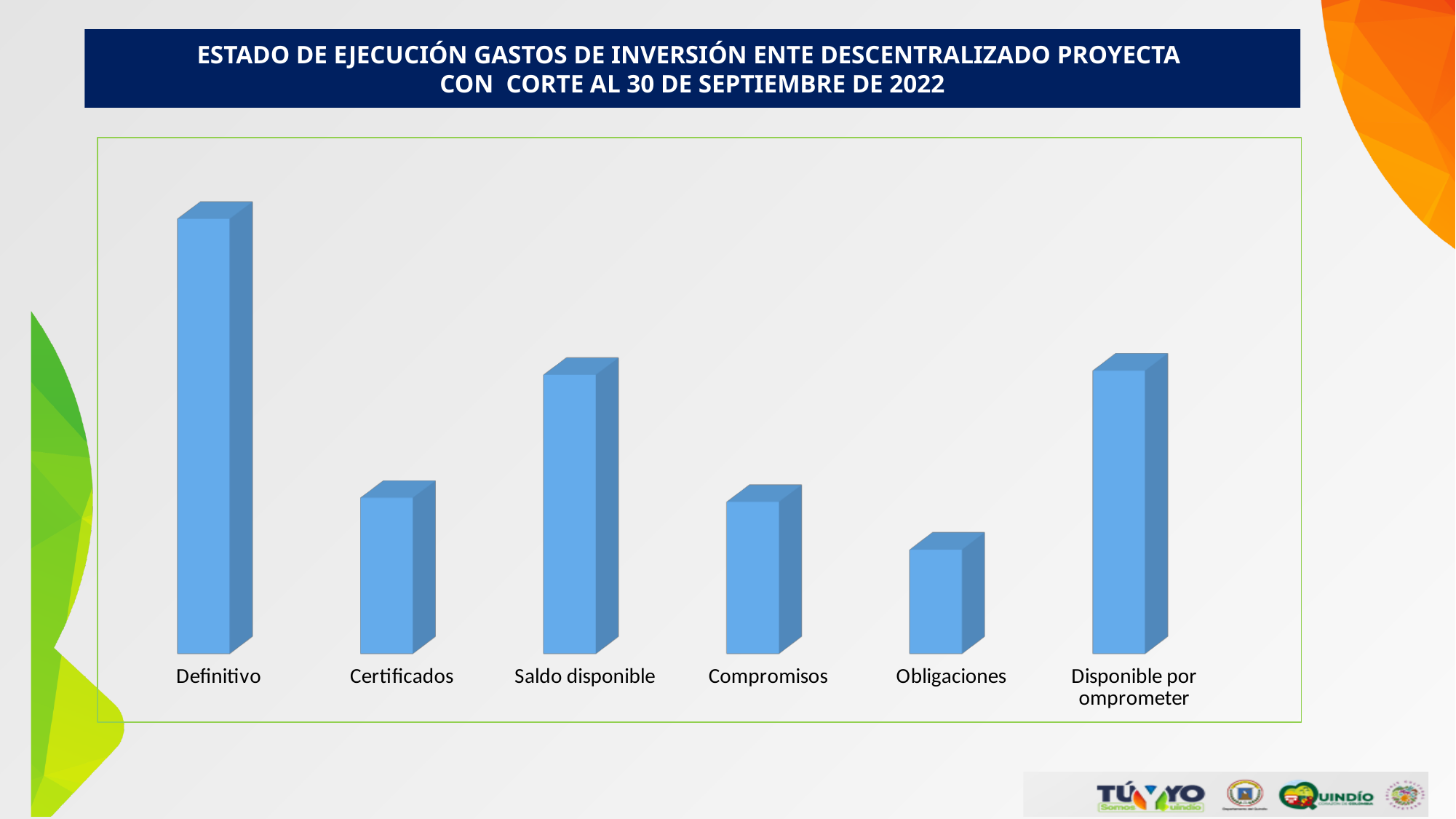
Which is larger, the bar for Compromisos or the bar for Obligaciones? Compromisos Which is larger, the bar for Certificados or the bar for Obligaciones? Certificados Which category has the highest bar? Definitivo Which is larger, the bar for Disponible por comprometer or the bar for Certificados? Disponible por comprometer Which category has the lowest bar? Obligaciones What is the title shown above the chart? ESTADO DE EJECUCIÓN GASTOS DE INVERSIÓN ENTE DESCENTRALIZADO PROYECTA CON CORTE AL 30 DE SEPTIEMBRE DE 2022 How many categories (bars) does the chart show? 6 What colour are the bars in the chart? Blue What kind of chart is shown on the slide? Bar chart